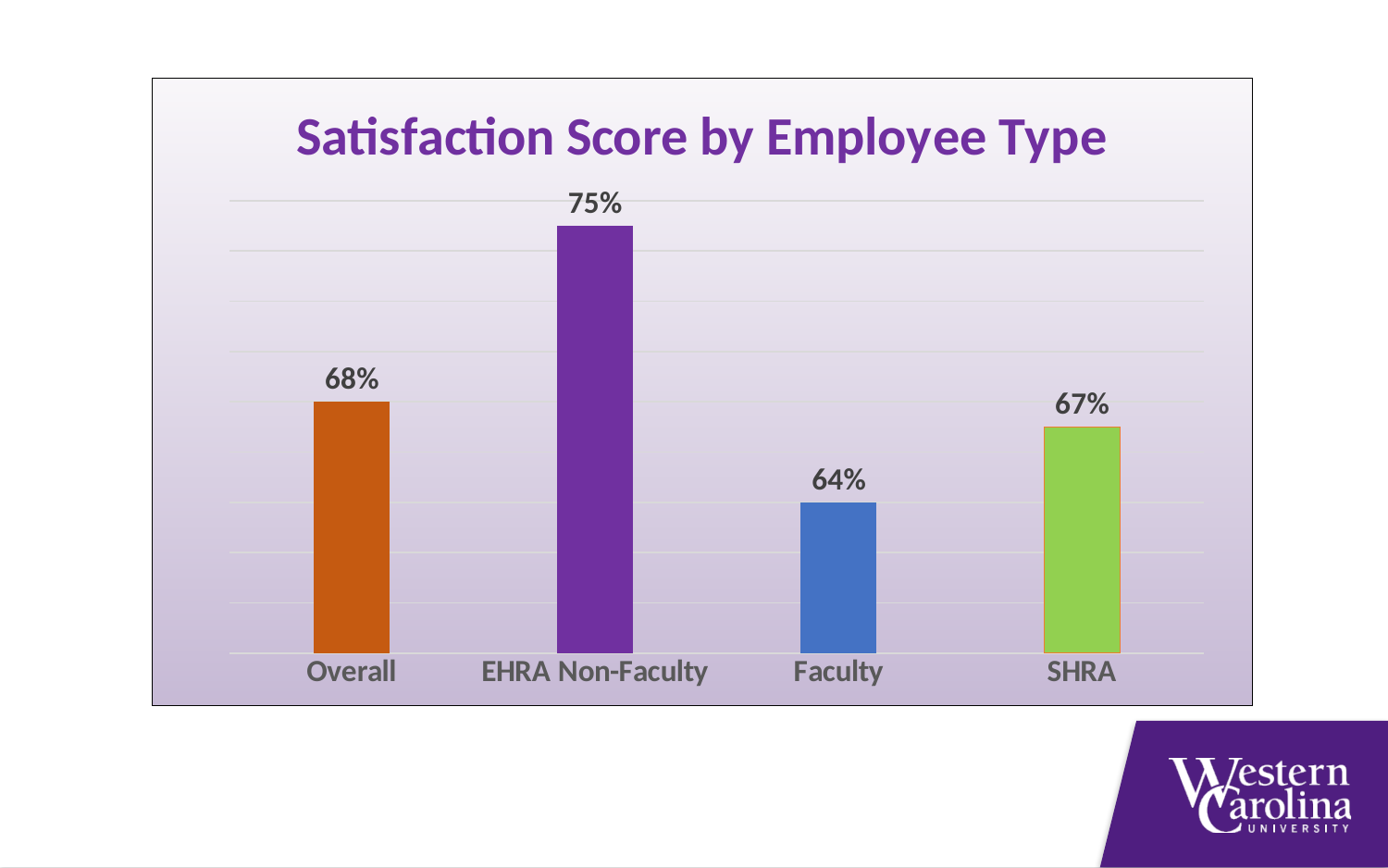
Which employee type has the highest satisfaction score? EHRA Non-Faculty What is the Overall satisfaction score? 68% What kind of chart is shown on the slide? Bar chart Which employee type has the lowest satisfaction score? Faculty What is the difference between the EHRA Non-Faculty and Faculty satisfaction scores? 11% What is the title of the chart? Satisfaction Score by Employee Type What is the satisfaction score for SHRA? 67% What is the satisfaction score for EHRA Non-Faculty? 75% How many employee types are shown in the chart? 4 Which has a higher satisfaction score, Faculty or SHRA? SHRA What is the difference between the Overall and SHRA satisfaction scores? 1% What is the satisfaction score for Faculty? 64%